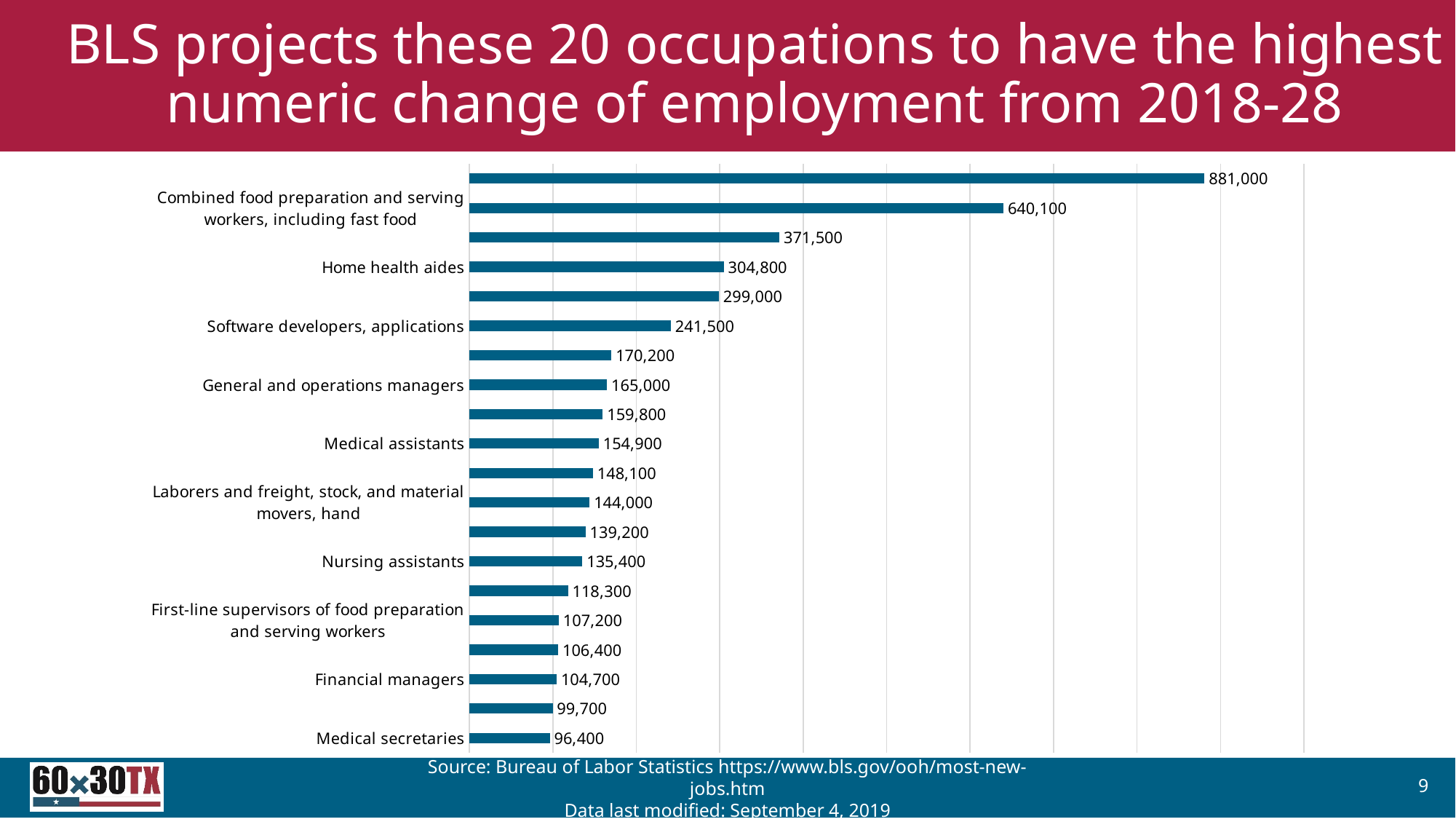
What is the value for Combined food preparation and serving workers, including fast food? 640,100 How many bars are plotted on the chart? 20 What is the largest value shown on the chart? 881,000 What is the value for Financial managers? 104,700 What value is shown for Nursing assistants? 135,400 Which labeled occupation has the lowest value on the chart? Medical secretaries What is the difference between the values for Home health aides and Software developers, applications? 63,300 Do the bar values increase or decrease from the top of the chart to the bottom? Decrease What value is shown for Software developers, applications? 241,500 What is the projected numeric change of employment for Home health aides? 304,800 What kind of chart is shown on the slide? Bar chart Which has a larger value: General and operations managers or Medical assistants? General and operations managers